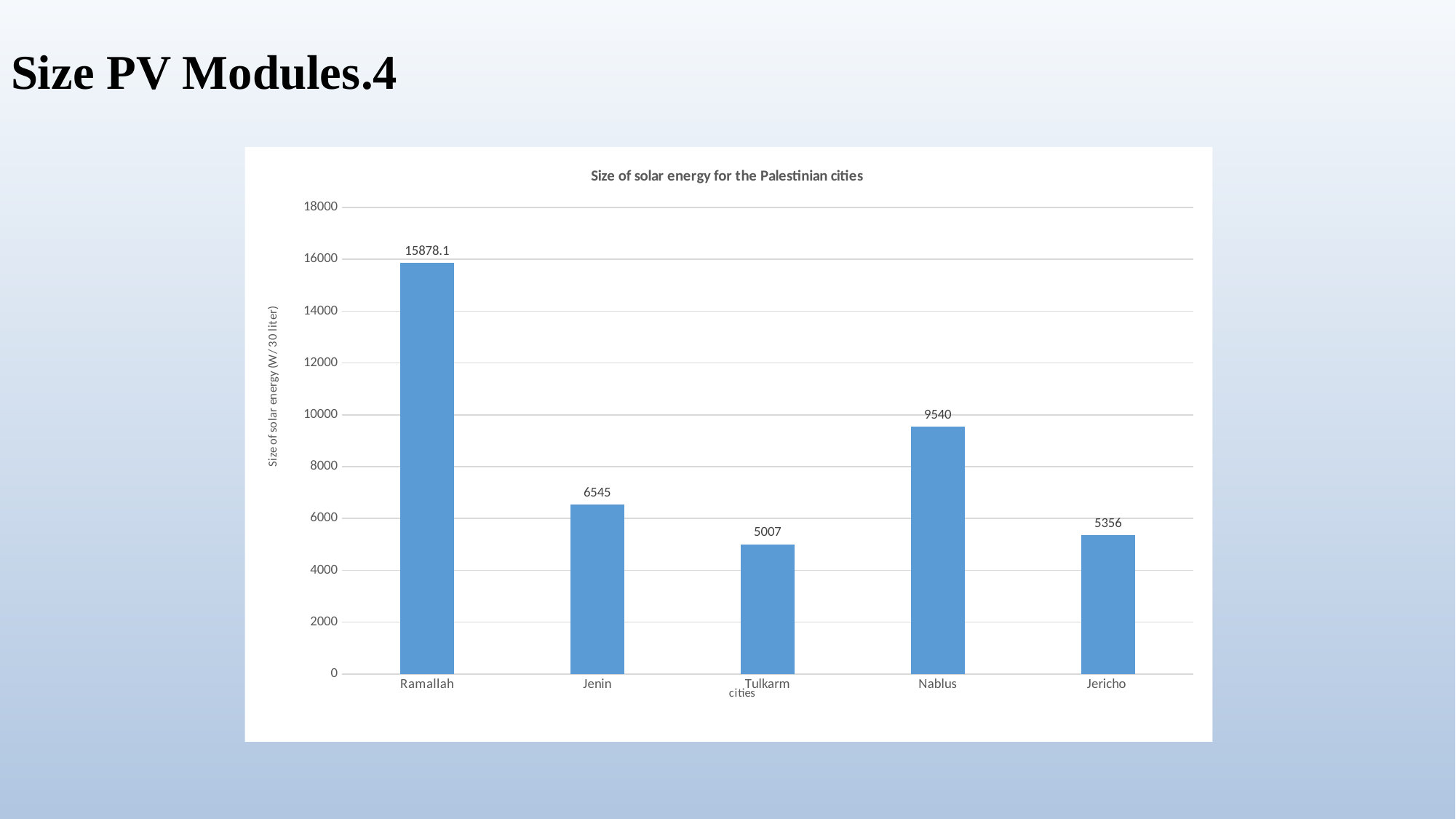
What is the label of the vertical axis? Size of solar energy (W/ 30 liter) What is the value for Tulkarm? 5007 Which city has the lowest value? Tulkarm Which city has the highest value? Ramallah How many cities are shown on the chart? 5 What is the value for Ramallah? 15878.1 What is the value for Nablus? 9540 Is the value for Jericho greater or less than 6000? less What is the title of the chart? Size of solar energy for the Palestinian cities Which is larger, the value for Nablus or the value for Jenin? Nablus What is the difference between the values for Jenin and Jericho? 1189 What kind of chart is shown on the slide? bar chart